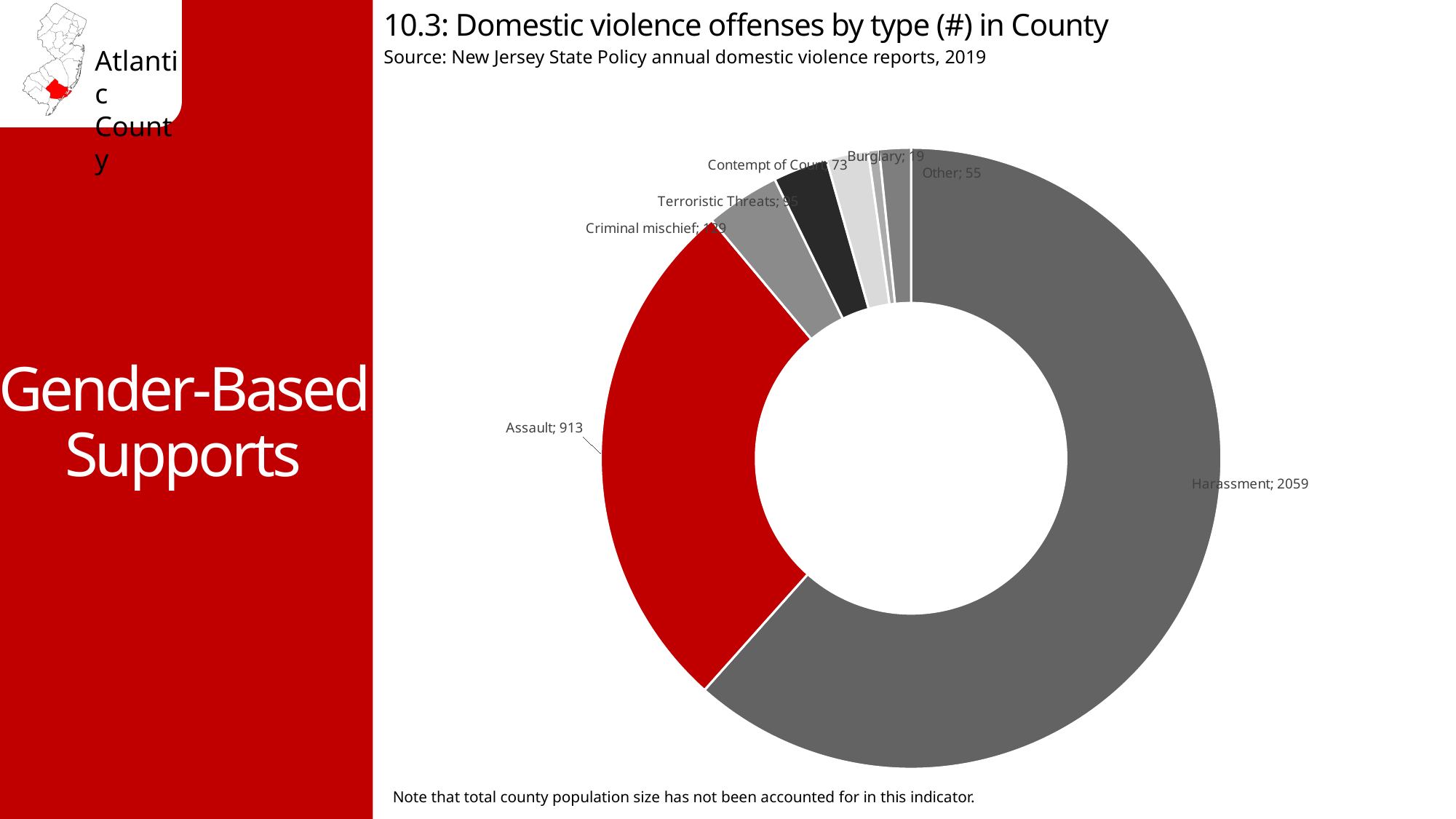
What is the value for Contempt of Court on the chart? 73 Which is larger, the value for Other or the value for Contempt of Court? Contempt of Court Which offense type has the lowest number of offenses? Burglary What is the value for the Other category on the chart? 55 What is the number of Harassment offenses shown on the chart? 2059 How many offense categories are shown on the chart? 7 What is the number of Assault offenses shown on the chart? 913 What is the value for Burglary on the chart? 19 Which offense type has the highest number of offenses? Harassment What is the difference between the Other and Burglary counts? 36 What type of chart is used on this slide? doughnut chart What is the difference between the Harassment and Assault counts? 1146